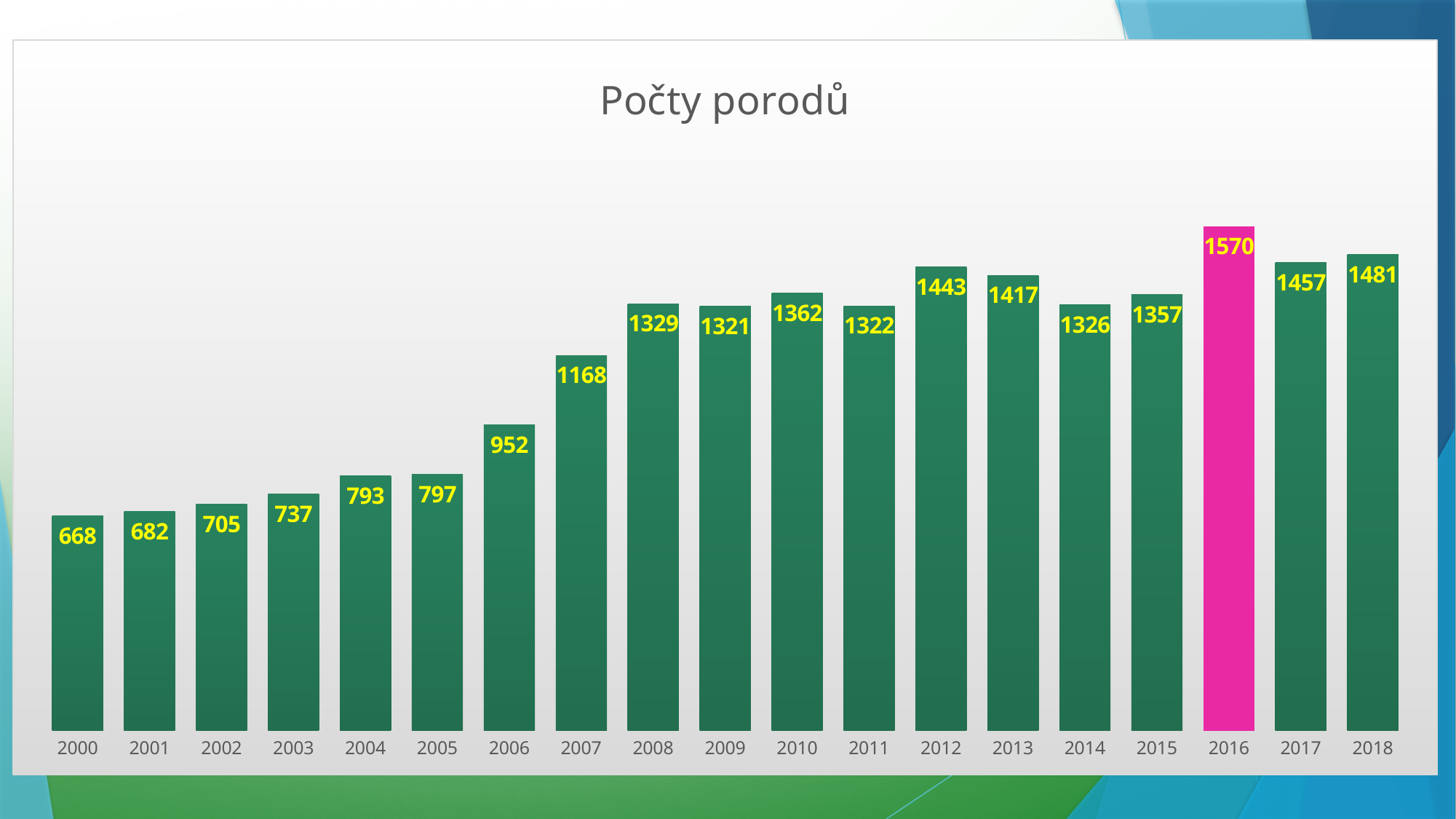
Which is larger, the value for 2012 or the value for 2013? 2012 What is the value for 2000? 668 What is the title of the chart? Počty porodů Which year has the highest value? 2016 What is the value for 2007? 1168 Which year has the lowest value? 2000 Do the values generally rise or fall from 2000 to 2018? rise What kind of chart is this? bar chart What is the value for 2016? 1570 What is the difference between the values for 2016 and 2000? 902 What is the difference between the values for 2018 and 2017? 24 How many years are shown on the x axis? 19